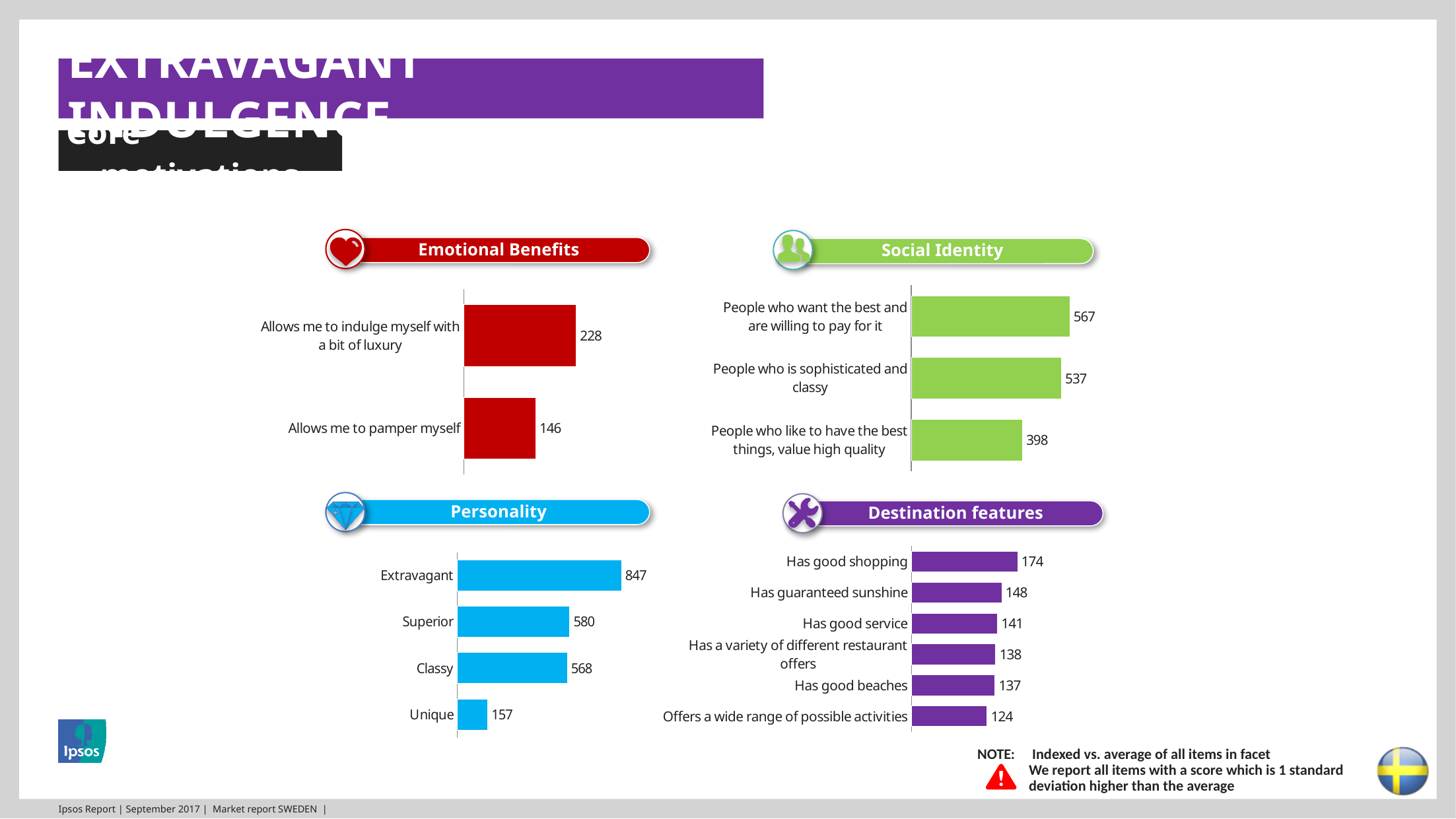
In the Destination features chart, how many categories are shown? 6 In the Personality chart, what is the difference between "Extravagant" and "Classy"? 279 In the Social Identity chart, what is the value for "People who like to have the best things, value high quality"? 398 In the Emotional Benefits chart, what is the difference between the two bars? 82 In the Personality chart, which category has the lowest value? Unique In the Social Identity chart, which category has the highest value? People who want the best and are willing to pay for it In the Social Identity chart, how many categories are shown? 3 In the Personality chart, what is the value for "Superior"? 580 In the Emotional Benefits chart, what is the value for "Allows me to indulge myself with a bit of luxury"? 228 What kind of chart is the Personality chart? Bar chart In the Destination features chart, which category has the highest value? Has good shopping In the Destination features chart, what is the value for "Has guaranteed sunshine"? 148